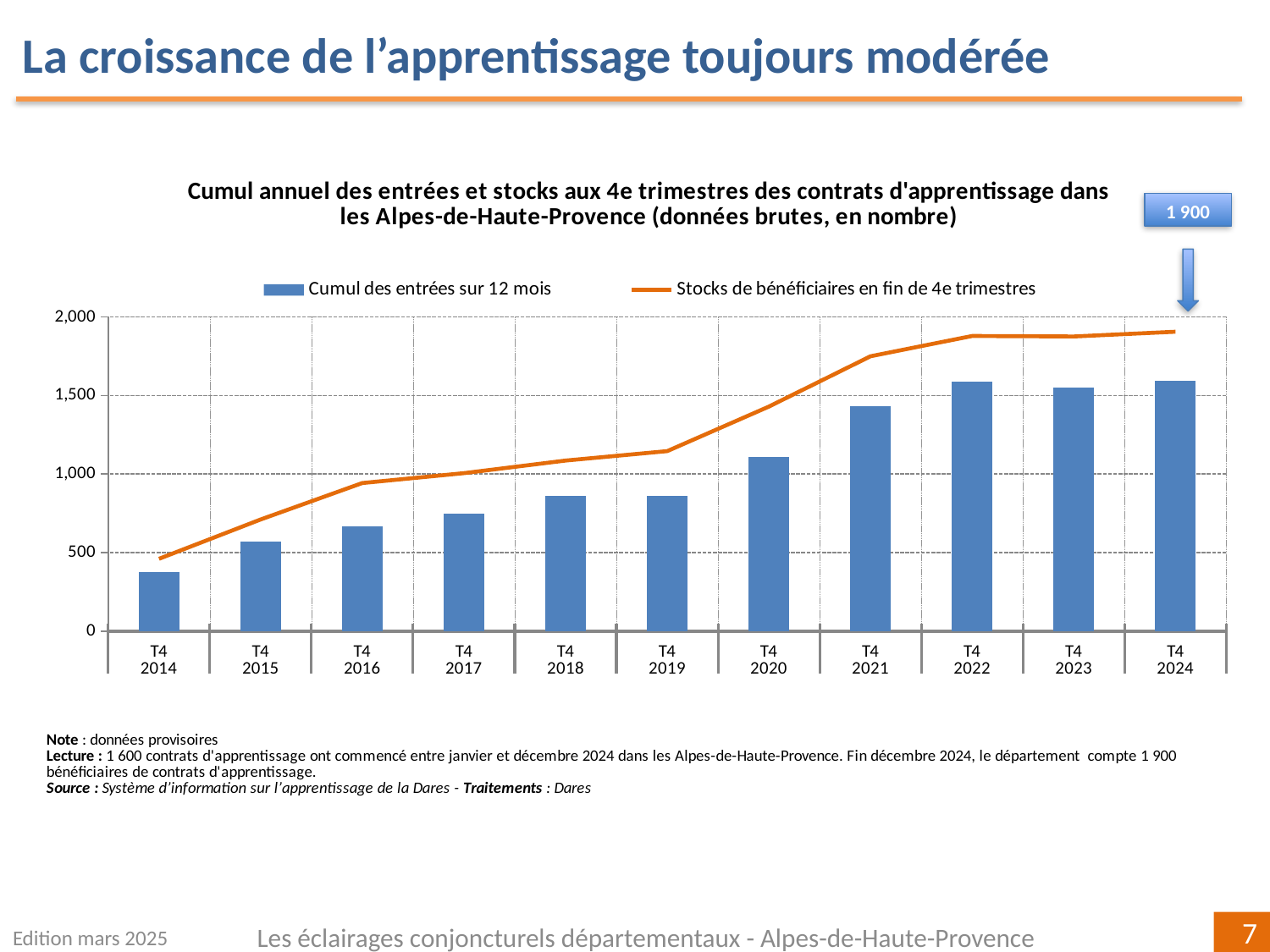
Is the value of 'Cumul des entrées sur 12 mois' for T4 2014 greater or less than 500? less At T4 2024, which series has the higher value: 'Cumul des entrées sur 12 mois' or 'Stocks de bénéficiaires en fin de 4e trimestres'? Stocks de bénéficiaires en fin de 4e trimestres Is the value of 'Stocks de bénéficiaires en fin de 4e trimestres' for T4 2016 greater or less than 1,000? less How many quarters are shown on the x axis of the chart? 11 Does the 'Stocks de bénéficiaires en fin de 4e trimestres' line generally rise or fall from T4 2014 to T4 2024? rise Which is larger for 'Cumul des entrées sur 12 mois': T4 2019 or T4 2021? T4 2021 How many series does the legend list? 2 What is the value of the stock of beneficiaries at the end of T4 2024, as shown by the callout label? 1 900 What kind of chart is shown on the slide? bar and line chart Is the value of 'Cumul des entrées sur 12 mois' for T4 2020 greater or less than 1,000? greater Which quarter has the lowest value for 'Cumul des entrées sur 12 mois'? T4 2014